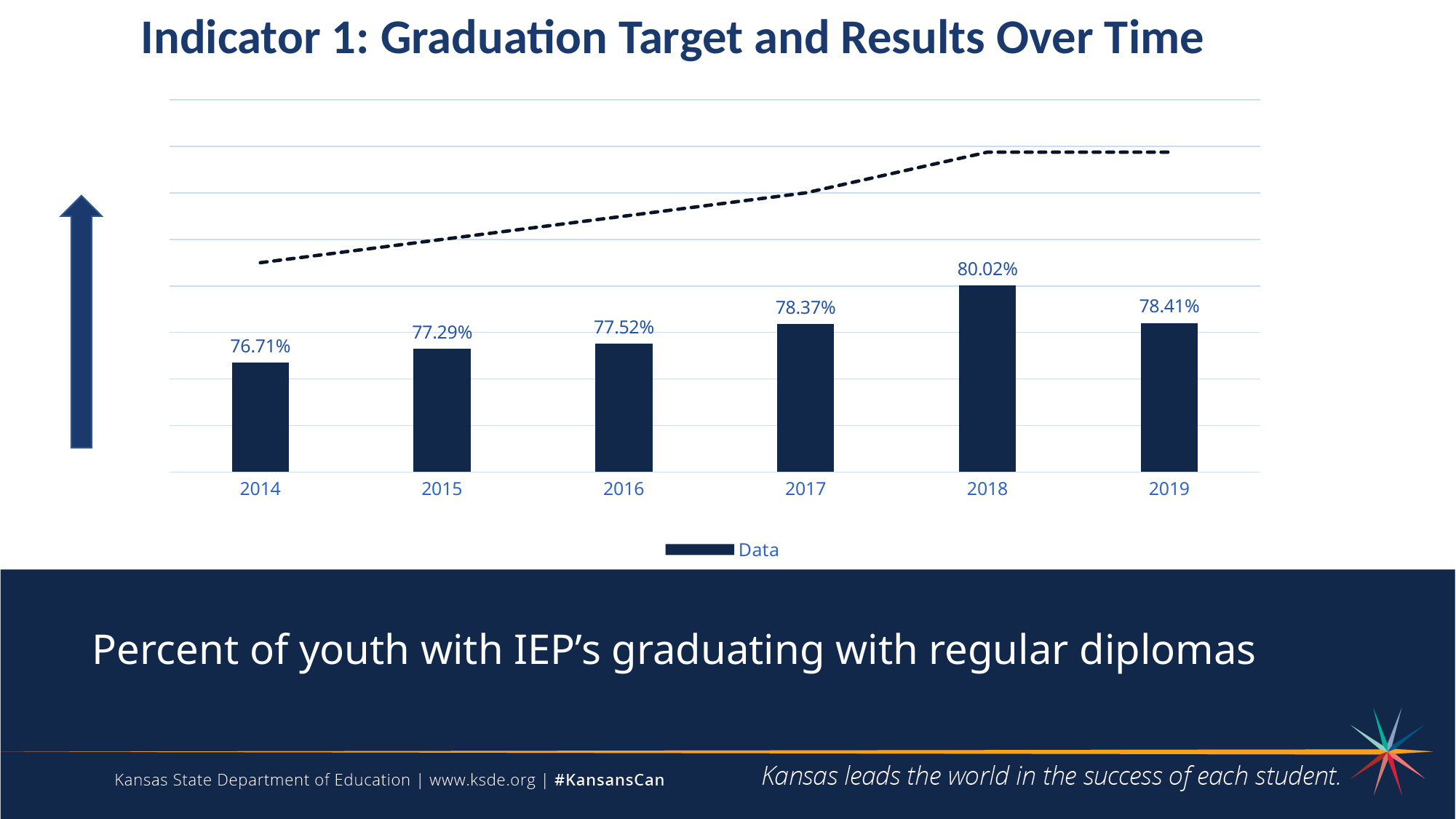
Which is larger, the value for 2017 or the value for 2016? 2017 How many years are shown on the x axis? 6 What is the difference between the values for 2018 and 2019? 1.61% What kind of chart is this? Combination bar and line chart What is the value for 2018? 80.02% What is the value for 2016? 77.52% Which year has the highest value? 2018 What is the difference between the values for 2015 and 2014? 0.58% What is the value for 2014? 76.71% What is the value for 2019? 78.41% Which year has the lowest value? 2014 What is the title of the chart? Indicator 1: Graduation Target and Results Over Time